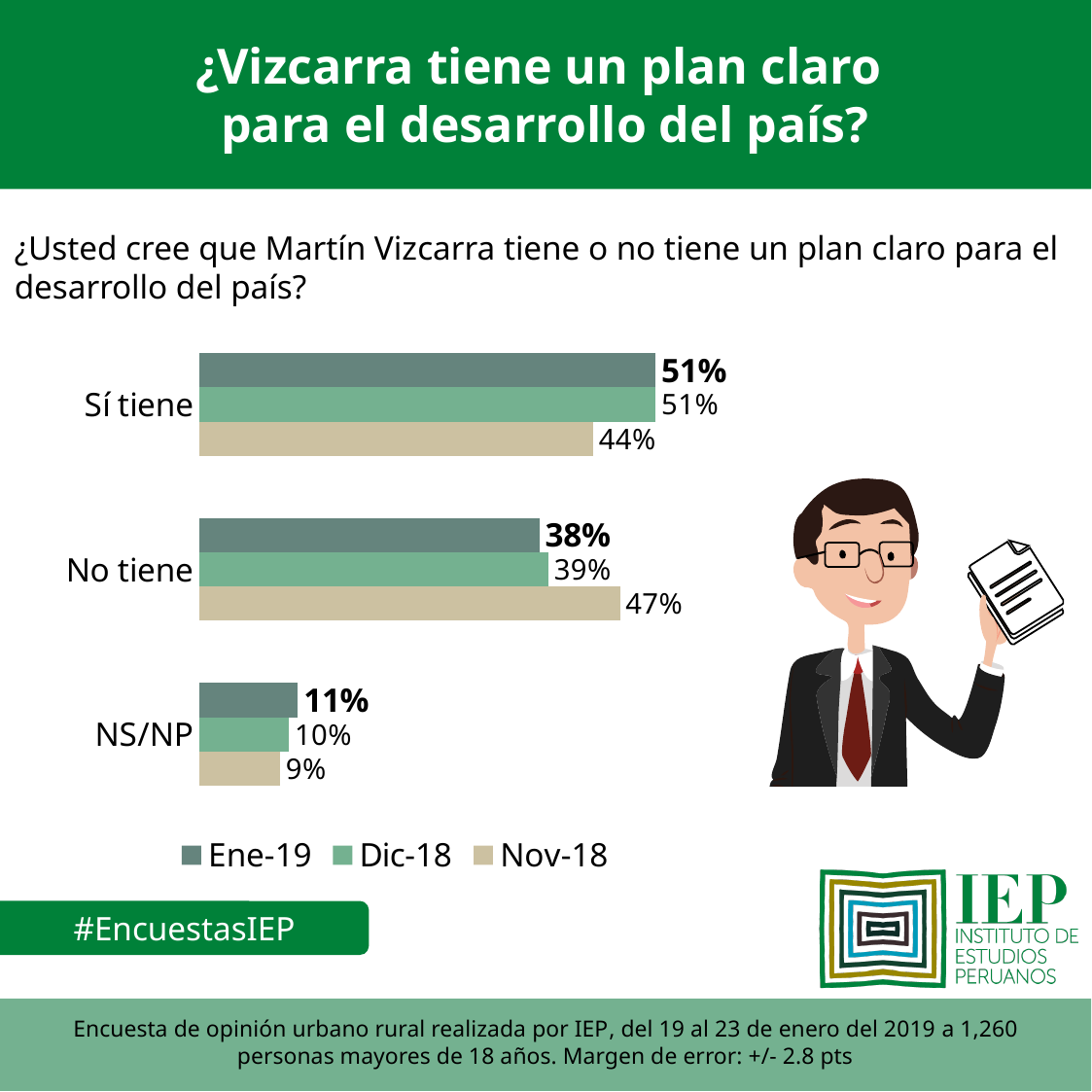
What kind of chart is shown on the slide? Bar chart What is the difference between the Nov-18 and Ene-19 values for "No tiene"? 9% What is the value for "Sí tiene" in the Ene-19 series? 51% Which category has the highest value in the Ene-19 series? Sí tiene What is the value for "No tiene" in the Nov-18 series? 47% How many categories are shown on the chart? 3 What is the value for "NS/NP" in the Dic-18 series? 10% Which series is shown in the lightest (beige) colour in the legend? Nov-18 What is the difference between the Ene-19 and Nov-18 values for "Sí tiene"? 7% How many series does the legend list? 3 Which category has the lowest value in the Nov-18 series? NS/NP In the Nov-18 series, which is larger: "Sí tiene" or "No tiene"? No tiene